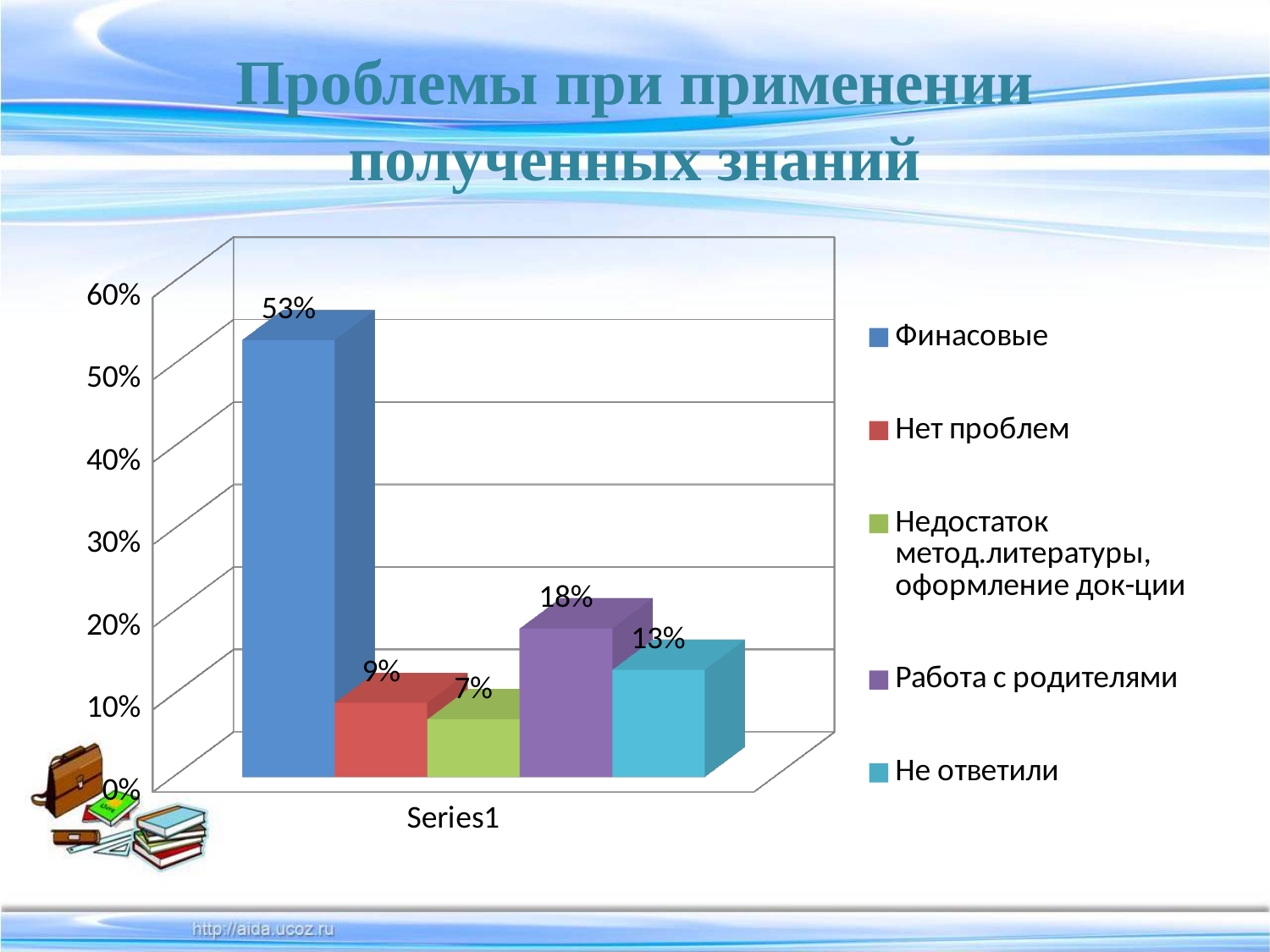
Is the value for Финасовые greater or less than 50%? greater What is the value for Не ответили? 13% What is the difference between the values for Финасовые and Работа с родителями? 35% What kind of chart is shown on the slide? bar chart What is the value for Работа с родителями? 18% What is the title of the chart on the slide? Проблемы при применении полученных знаний What is the value for Нет проблем? 9% Which category has the highest value? Финасовые How many bars are plotted in the chart? 5 What is the value for Финасовые? 53% Which is larger, the value for Работа с родителями or the value for Не ответили? Работа с родителями Which category has the lowest value? Недостаток метод.литературы, оформление док-ции